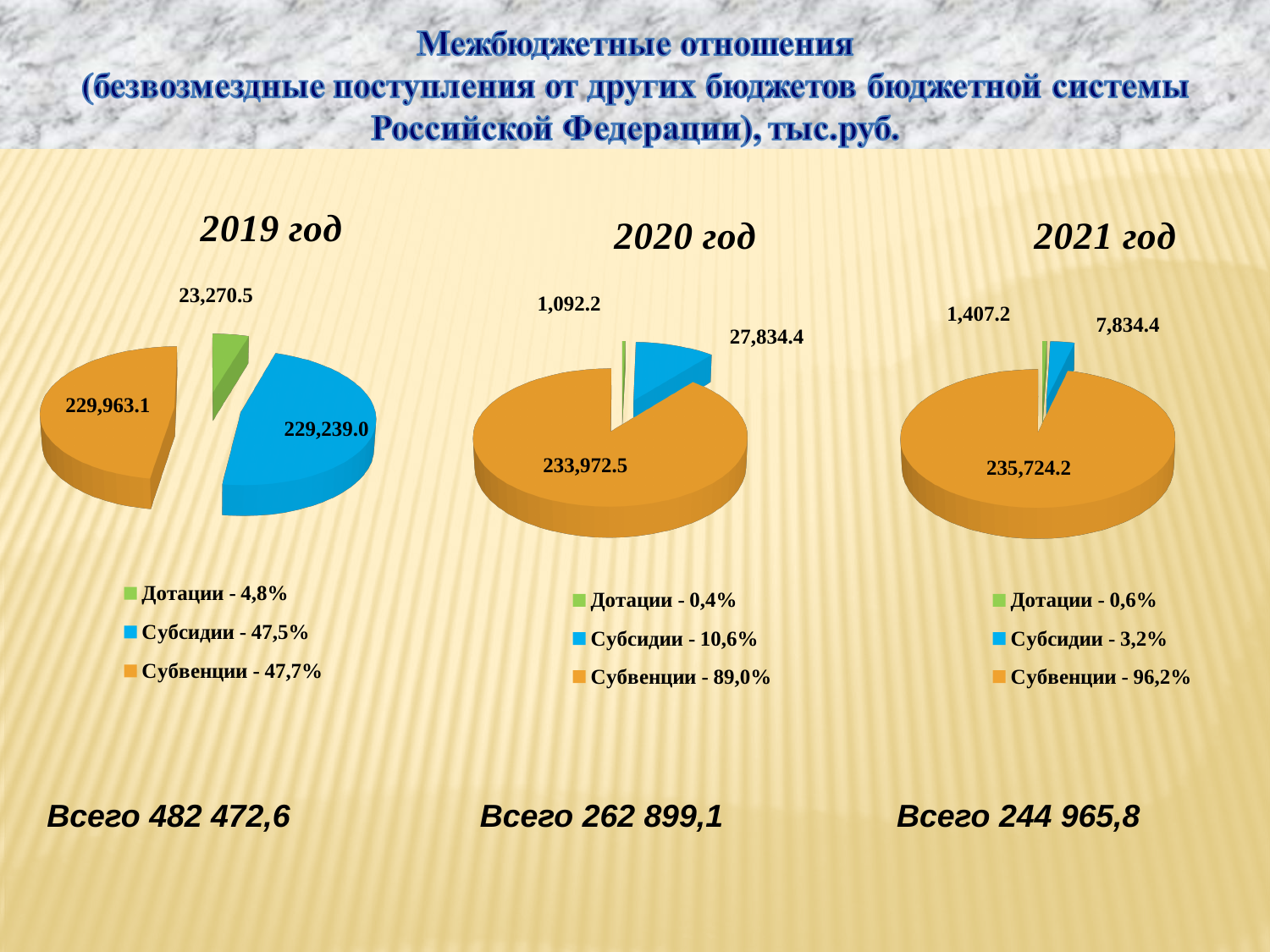
In the 2020 год pie chart, what share of the pie does Субвенции represent according to the legend? 89,0% How many categories does the 2019 год pie chart show? 3 In the 2019 год pie chart, which category has the smallest value? Дотации In the 2020 год pie chart, what is the value for Субвенции? 233,972.5 In the 2020 год pie chart, which category has the smallest value? Дотации In the 2021 год pie chart, what share of the pie does Субсидии represent according to the legend? 3,2% What type of chart is used for the 2020 год data? Pie chart In the 2021 год pie chart, which category has the largest value? Субвенции In the 2019 год pie chart, what is the value for Субсидии? 229,239.0 In the 2020 год pie chart, what is the difference between the values for Субвенции and Субсидии? 206,138.1 In the 2021 год pie chart, which is larger, the value for Субсидии or the value for Дотации? Субсидии In the 2021 год pie chart, what is the value for Дотации? 1,407.2